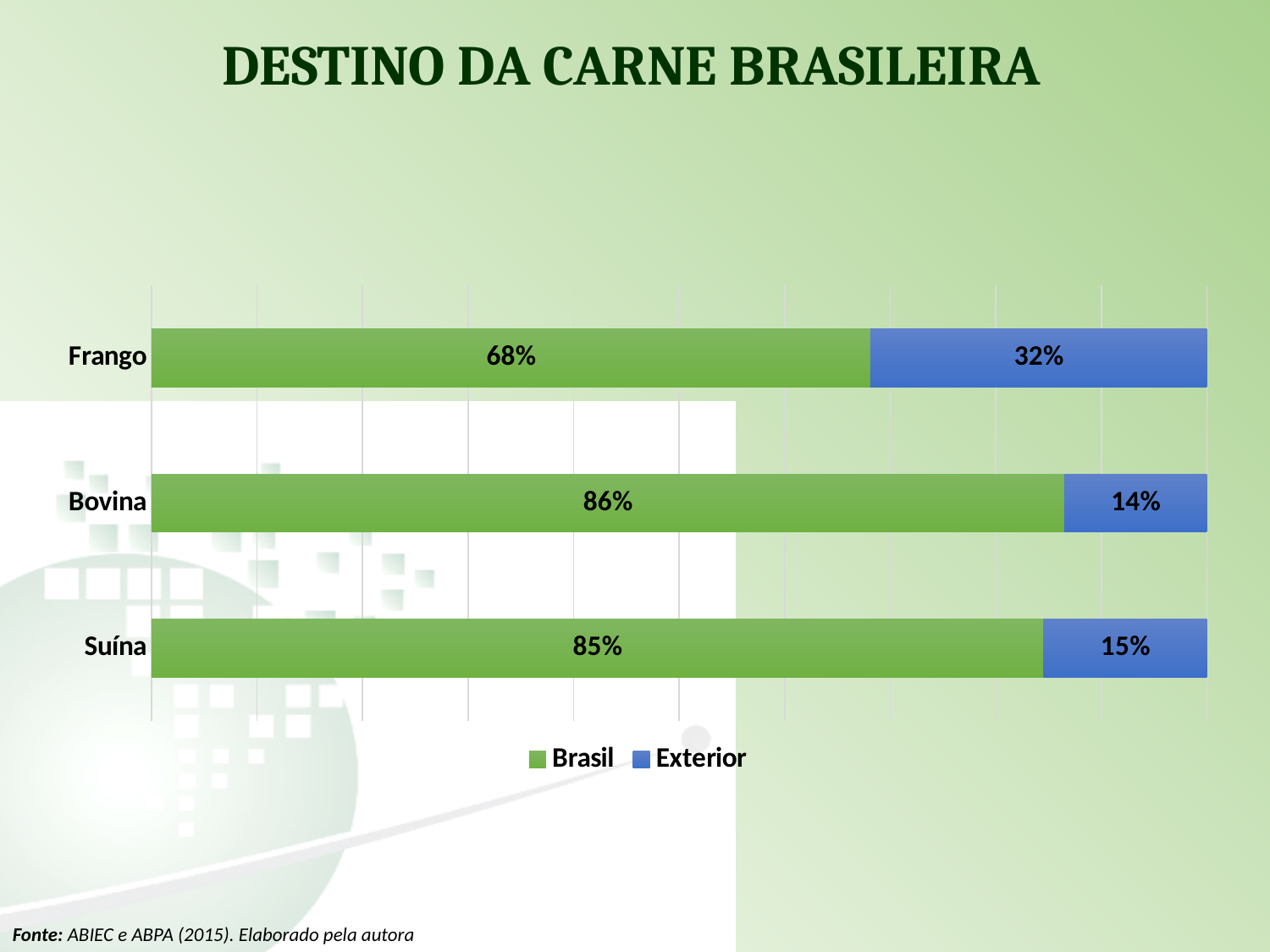
What is the Exterior value for Suína? 15% How many series does the legend list? 2 What is the Exterior value for Bovina? 14% Which category has the lowest Brasil share? Frango What kind of chart is shown on the slide? Stacked bar chart Which category has the highest Exterior share? Frango How many categories are shown on the chart? 3 What is the title of the chart? DESTINO DA CARNE BRASILEIRA What is the Brasil value for Frango? 68% What is the Brasil value for Bovina? 86% Which is larger, the Brasil value for Suína or the Brasil value for Frango? Suína What is the difference between the Exterior values for Frango and Bovina? 18%